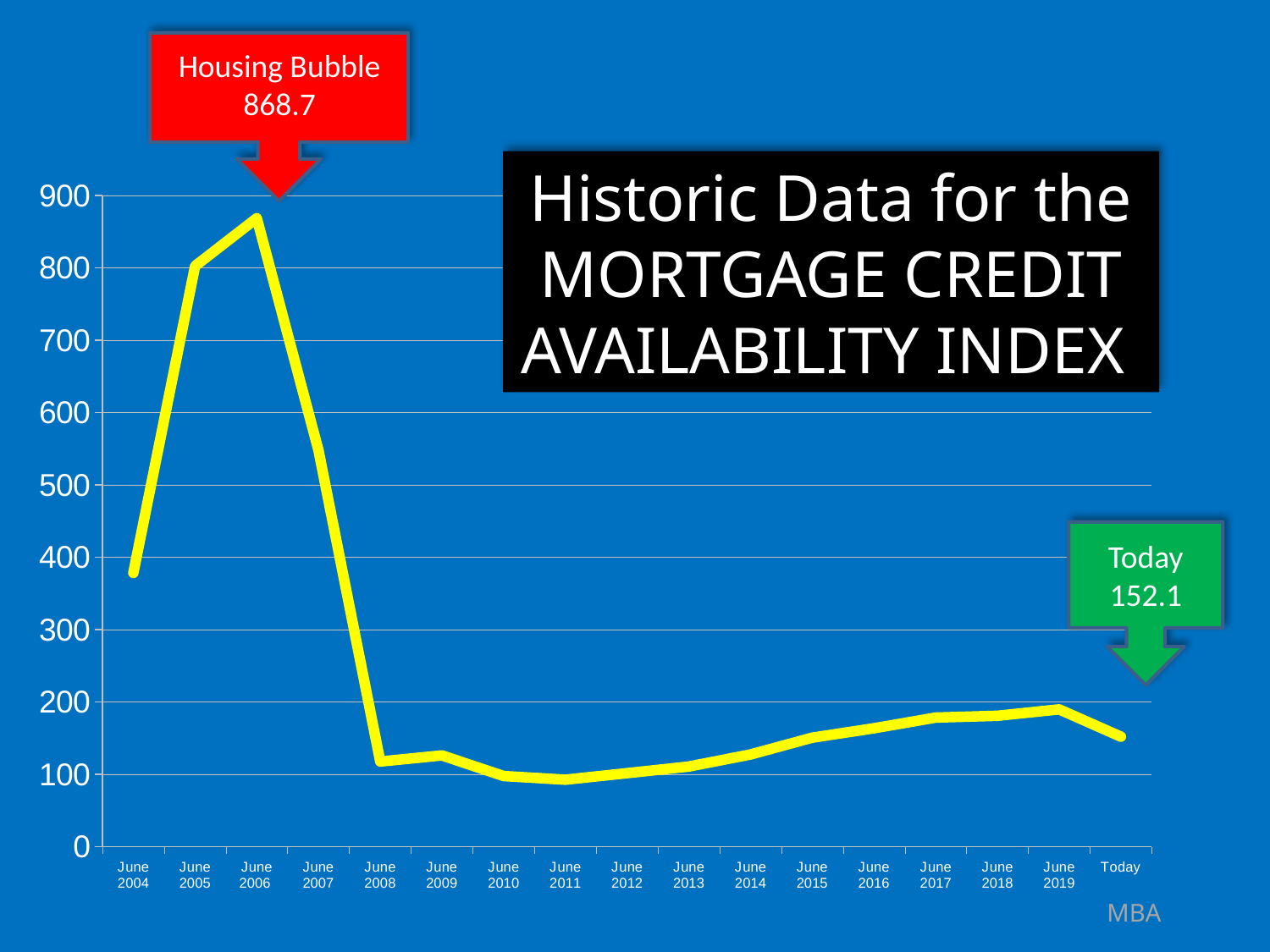
Is the value for June 2004 greater or less than 300? greater What is the difference between the Housing Bubble value and the Today value? 716.6 What is the value of the Mortgage Credit Availability Index for Today? 152.1 Is the value for June 2008 greater or less than 200? less What kind of chart is shown on the slide? line chart What is the title of the chart? Historic Data for the MORTGAGE CREDIT AVAILABILITY INDEX Which point on the x axis has the highest value? June 2006 Does the index rise or fall between June 2006 and June 2008? fall Which is larger, the value for June 2005 or the value for June 2008? June 2005 What is the value of the Mortgage Credit Availability Index at the Housing Bubble peak (June 2006)? 868.7 Is the value for June 2017 greater or less than 100? greater How many points are plotted along the x axis? 17